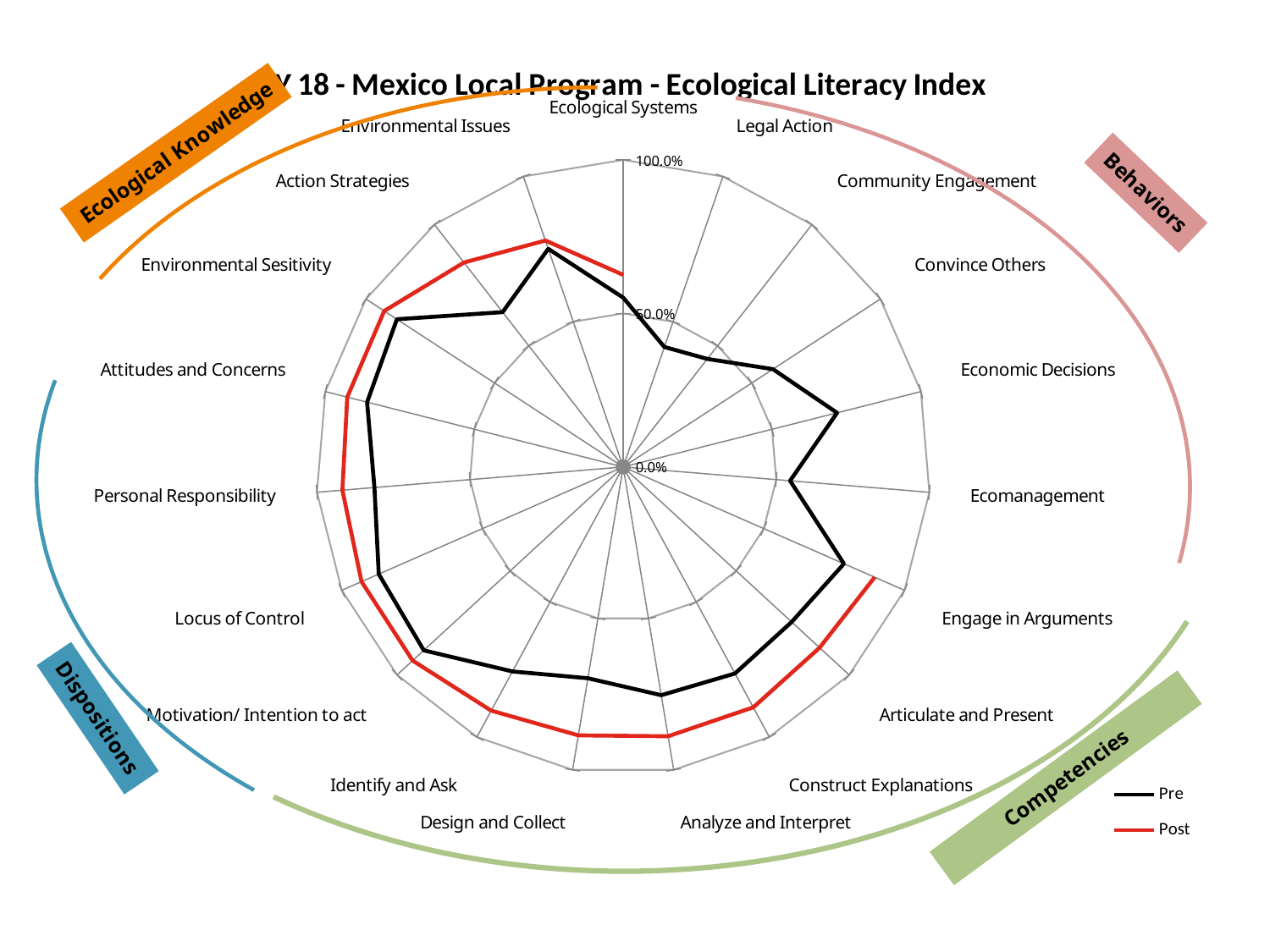
For Personal Responsibility, which series has the larger value, Pre or Post? Post How many categories (axes) does the radar chart have? 19 Is the Post value for Personal Responsibility greater or less than 50.0%? greater Which colour represents the Post series? Red How many series does the legend list? 2 Is the Pre value for Legal Action greater or less than 50.0%? less For the Pre series, which is larger: Economic Decisions or Legal Action? Economic Decisions Is the Pre value for Economic Decisions greater or less than 50.0%? greater Which category has the lowest Pre value? Legal Action What are the two series named in the legend? Pre and Post What kind of chart is shown on the slide? Radar chart